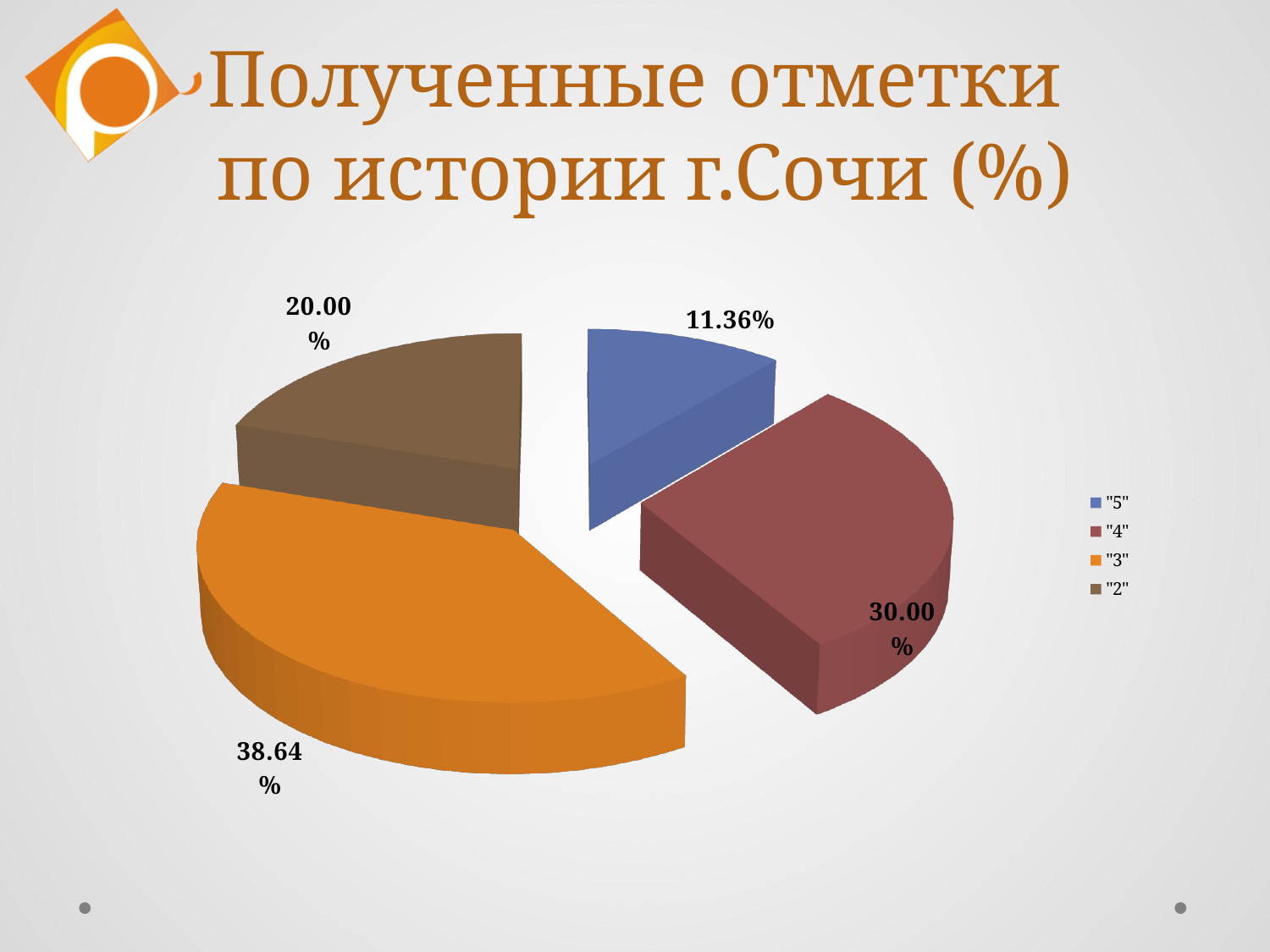
Which mark has the largest share of the pie? "3" What is the difference in percentage points between the share of "3" and the share of "4"? 8.64 What percentage of marks are "4"? 30.00% What is the title of the chart on the slide? Полученные отметки по истории г.Сочи (%) What percentage of marks are "2"? 20.00% What kind of chart is shown on the slide? Pie chart What is the difference in percentage points between the share of "2" and the share of "5"? 8.64 Which mark has the smallest share of the pie? "5" What percentage of marks are "3"? 38.64% What percentage of marks are "5"? 11.36% How many slices does the pie chart have? 4 Which is larger, the share of "4" or the share of "2"? "4"